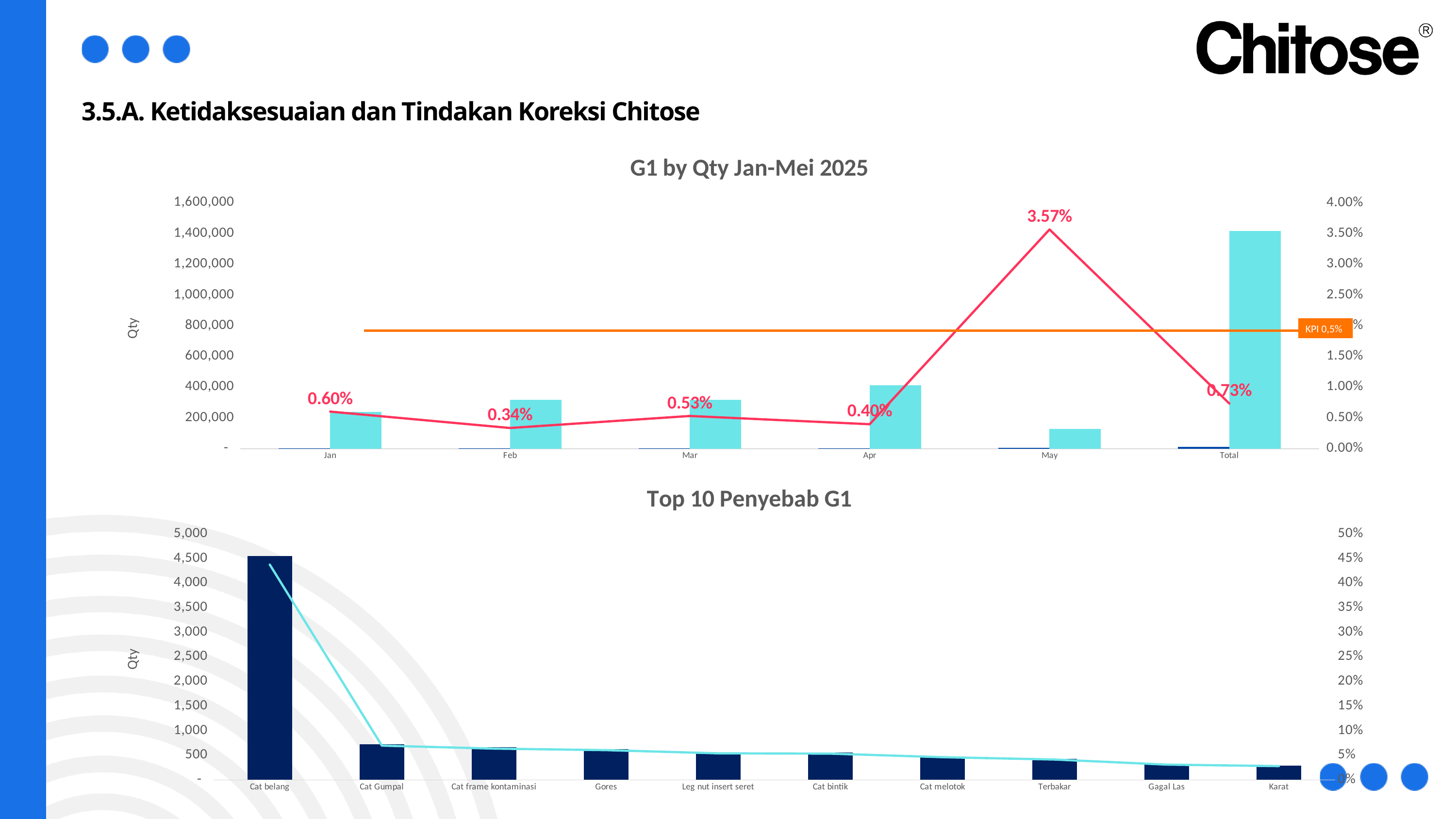
In the 'Top 10 Penyebab G1' chart, which category has the highest Qty bar? Cat belang How many categories are shown on the x axis of the 'Top 10 Penyebab G1' chart? 10 In the 'G1 by Qty Jan-Mei 2025' chart, is the Qty bar for Total greater or less than 1,200,000? greater In the 'G1 by Qty Jan-Mei 2025' chart, what label is shown on the orange horizontal line? KPI 0,5% In the 'G1 by Qty Jan-Mei 2025' chart, which has the higher percentage, Mar or Apr? Mar In the 'G1 by Qty Jan-Mei 2025' chart, which month has the highest percentage on the red line? May In the 'G1 by Qty Jan-Mei 2025' chart, which month has the lowest percentage on the red line? Feb In the 'G1 by Qty Jan-Mei 2025' chart, what percentage is shown for Total? 0.73% In the 'G1 by Qty Jan-Mei 2025' chart, what percentage is shown for May? 3.57% In the 'G1 by Qty Jan-Mei 2025' chart, what is the difference between the May percentage and the Jan percentage? 2.97% In the 'G1 by Qty Jan-Mei 2025' chart, what percentage is shown for Jan? 0.60% How many categories are shown on the x axis of the 'G1 by Qty Jan-Mei 2025' chart? 6